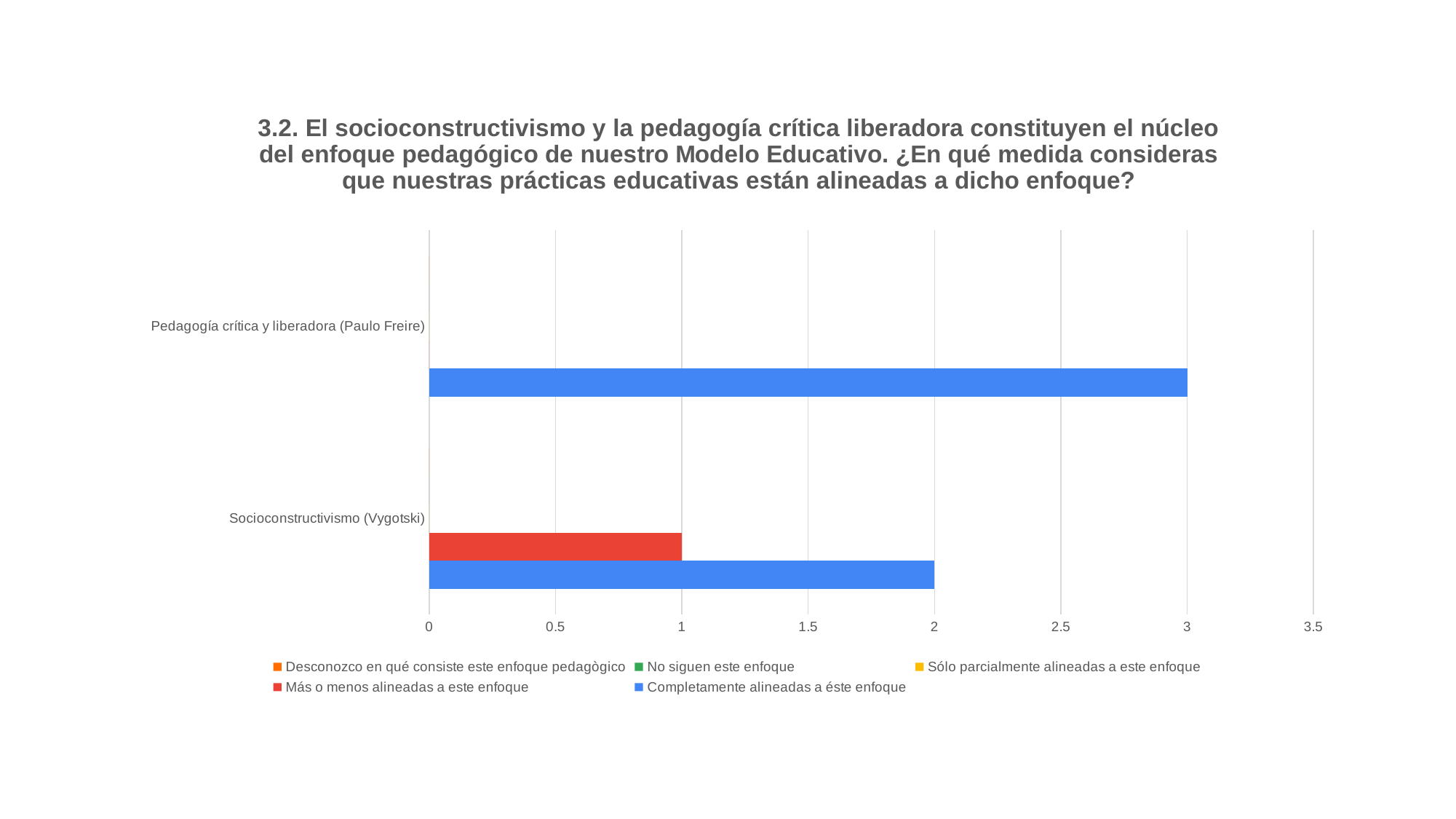
For Socioconstructivismo (Vygotski), which is larger: "Más o menos alineadas a este enfoque" or "Completamente alineadas a éste enfoque"? Completamente alineadas a éste enfoque What is the difference between the "Completamente alineadas a éste enfoque" values for Pedagogía crítica y liberadora (Paulo Freire) and Socioconstructivismo (Vygotski)? 1 Which category has the higher value for "Completamente alineadas a éste enfoque"? Pedagogía crítica y liberadora (Paulo Freire) What is the value of "Completamente alineadas a éste enfoque" for Socioconstructivismo (Vygotski)? 2 What kind of chart is shown on the slide? bar chart What is the total of the bars shown for Socioconstructivismo (Vygotski)? 3 What is the value of "Más o menos alineadas a este enfoque" for Socioconstructivismo (Vygotski)? 1 Is the value of "Completamente alineadas a éste enfoque" for Pedagogía crítica y liberadora (Paulo Freire) greater or less than 2.5? greater What is the value of "Completamente alineadas a éste enfoque" for Pedagogía crítica y liberadora (Paulo Freire)? 3 How many series does the legend list? 5 What colour represents "Completamente alineadas a éste enfoque" in the legend? blue How many categories are shown on the vertical axis of the chart? 2